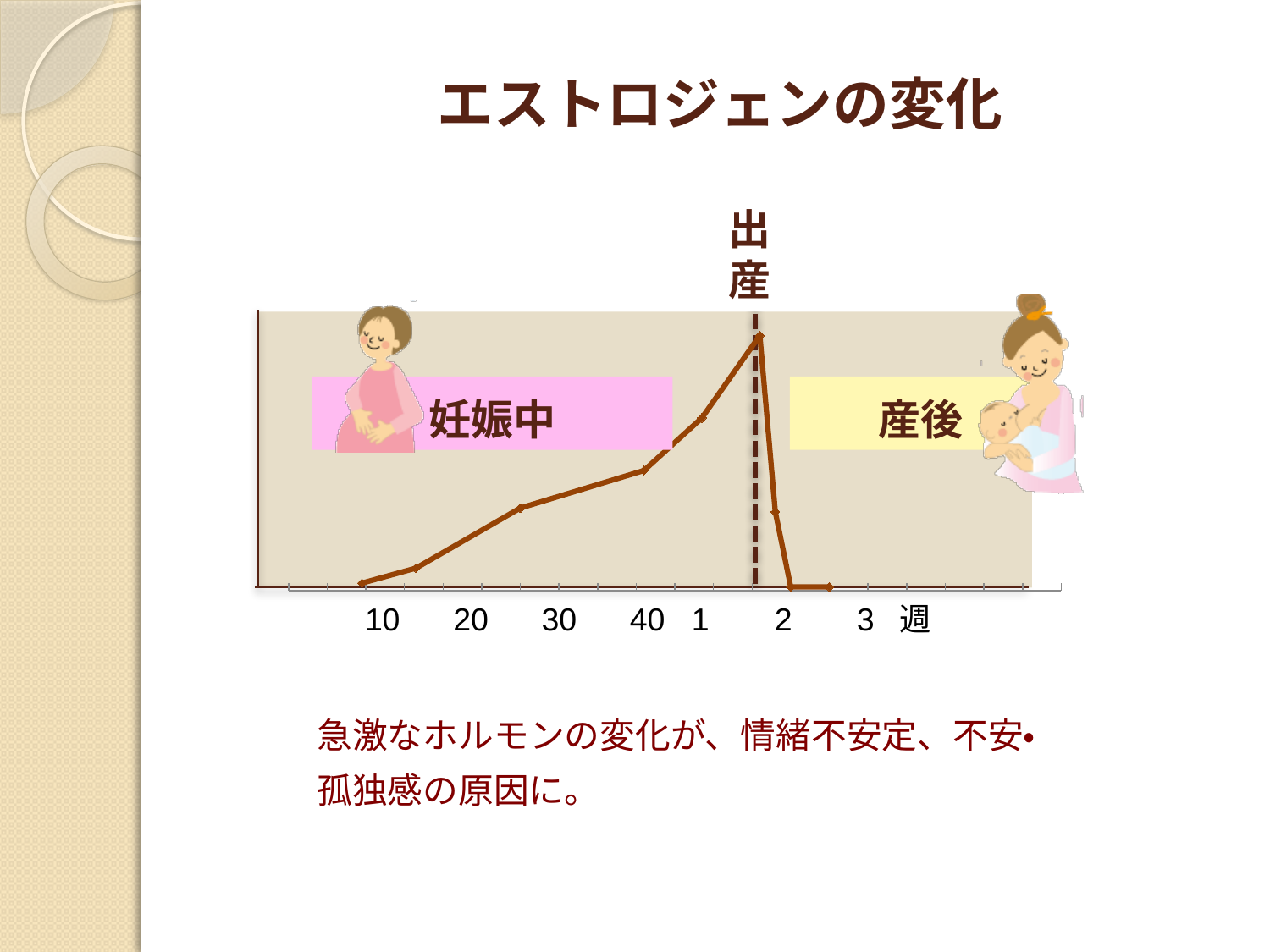
What unit is written at the end of the x axis? 週 Does the estrogen line rise or fall immediately after 出産? fall Which is higher on the estrogen line, the value at 出産 or the value at week 2 postpartum? 出産 Which is higher on the estrogen line, the value at week 30 or the value at week 10? week 30 Which is higher on the estrogen line, the value at week 40 of pregnancy or the value at week 3 postpartum? week 40 of pregnancy At which point on the x axis does the estrogen line reach its highest value? 出産 What kind of chart is shown on the slide? line chart What label is attached to the vertical dashed line in the chart? 出産 What is the title of the chart? エストロジェンの変化 Does the estrogen line rise or fall between week 10 and week 40 of pregnancy? rise